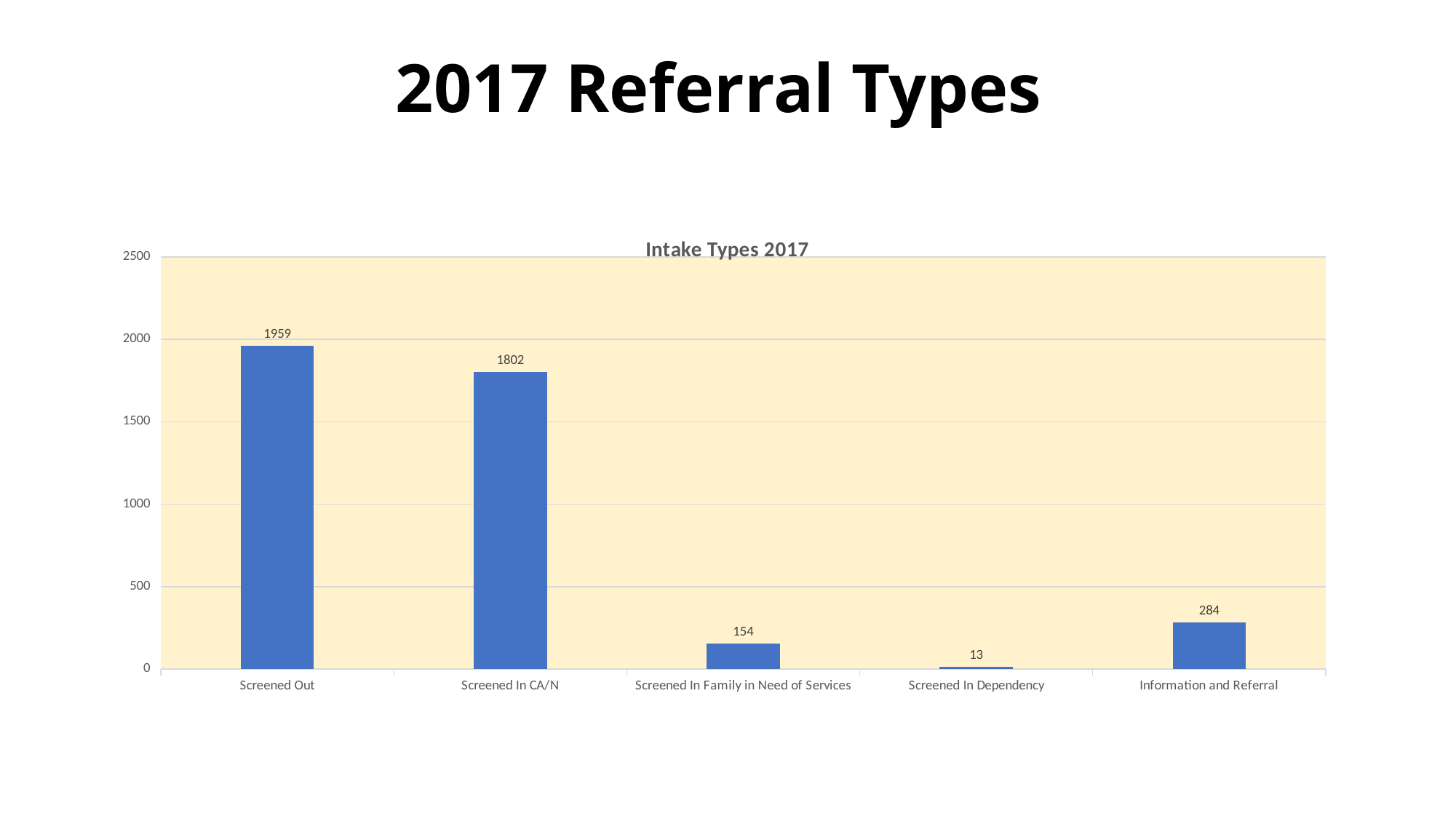
Which is larger, the value for Information and Referral or the value for Screened In Family in Need of Services? Information and Referral How many categories are shown on the x axis? 5 What is the difference between the values for Screened Out and Screened In CA/N? 157 What is the value for Information and Referral? 284 What is the value for Screened In Dependency? 13 Which category has the lowest value? Screened In Dependency What kind of chart is shown? Bar chart What is the title of the chart? Intake Types 2017 What is the value for Screened Out? 1959 What is the value for Screened In CA/N? 1802 Which category has the highest value? Screened Out What is the value for Screened In Family in Need of Services? 154